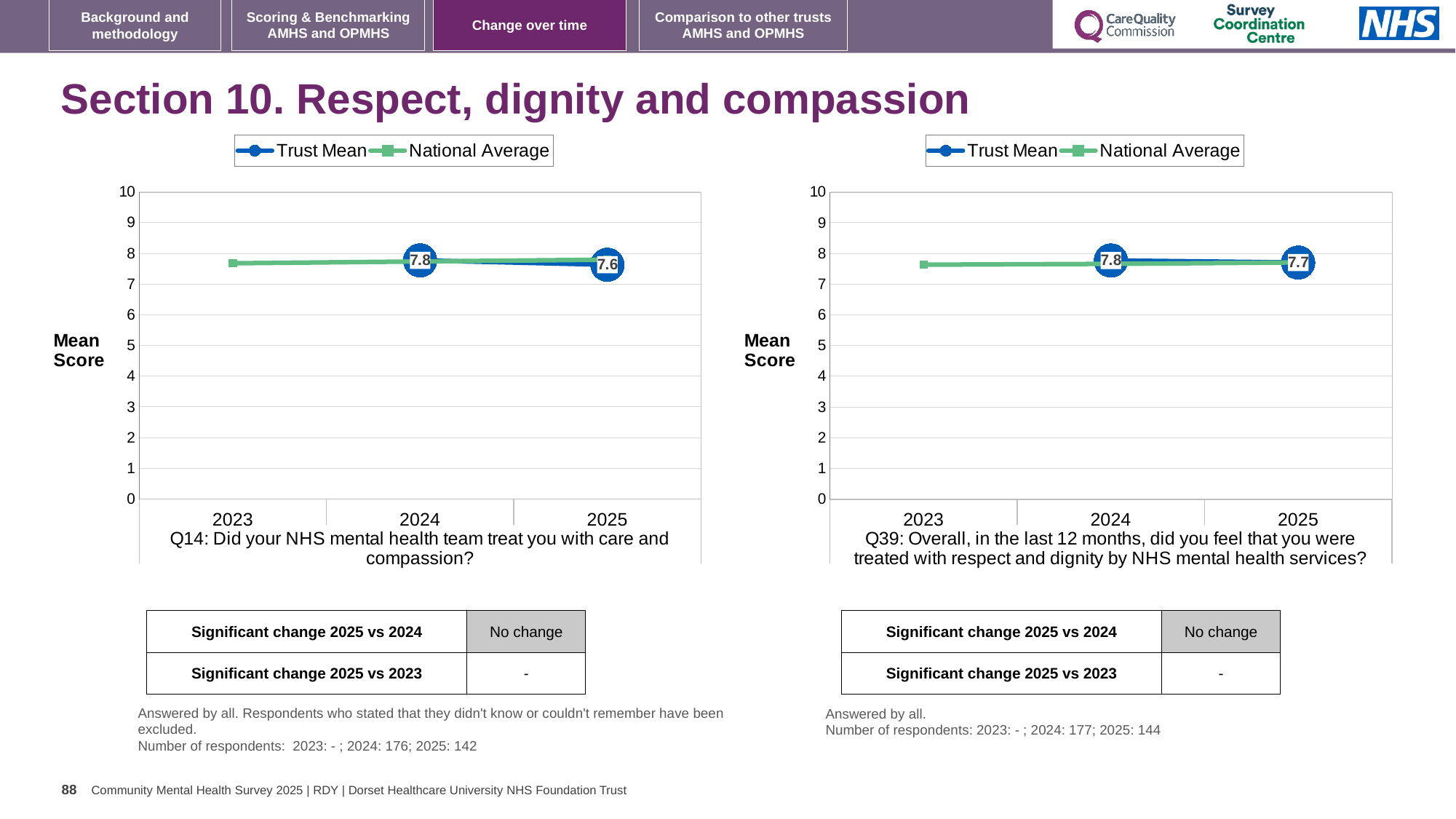
In the left chart (Q14), is the National Average value for 2023 greater or less than 7? greater In the right chart (Q39), is the National Average value for 2023 greater or less than 8? less In the left chart (Q14), does the Trust Mean rise or fall from 2024 to 2025? fall In the right chart (Q39), what is the Trust Mean score for 2025? 7.7 In the right chart (Q39), what is the Trust Mean score for 2024? 7.8 In the left chart (Q14), what is the Trust Mean score for 2025? 7.6 In the right chart (Q39), what is the difference between the Trust Mean scores for 2024 and 2025? 0.1 How many series does the legend of the left chart (Q14) list? 2 What kind of chart is the left chart (Q14)? line chart In the left chart (Q14), what is the Trust Mean score for 2024? 7.8 In the left chart (Q14), what is the difference between the Trust Mean scores for 2024 and 2025? 0.2 How many years are shown on the x axis of the right chart (Q39)? 3